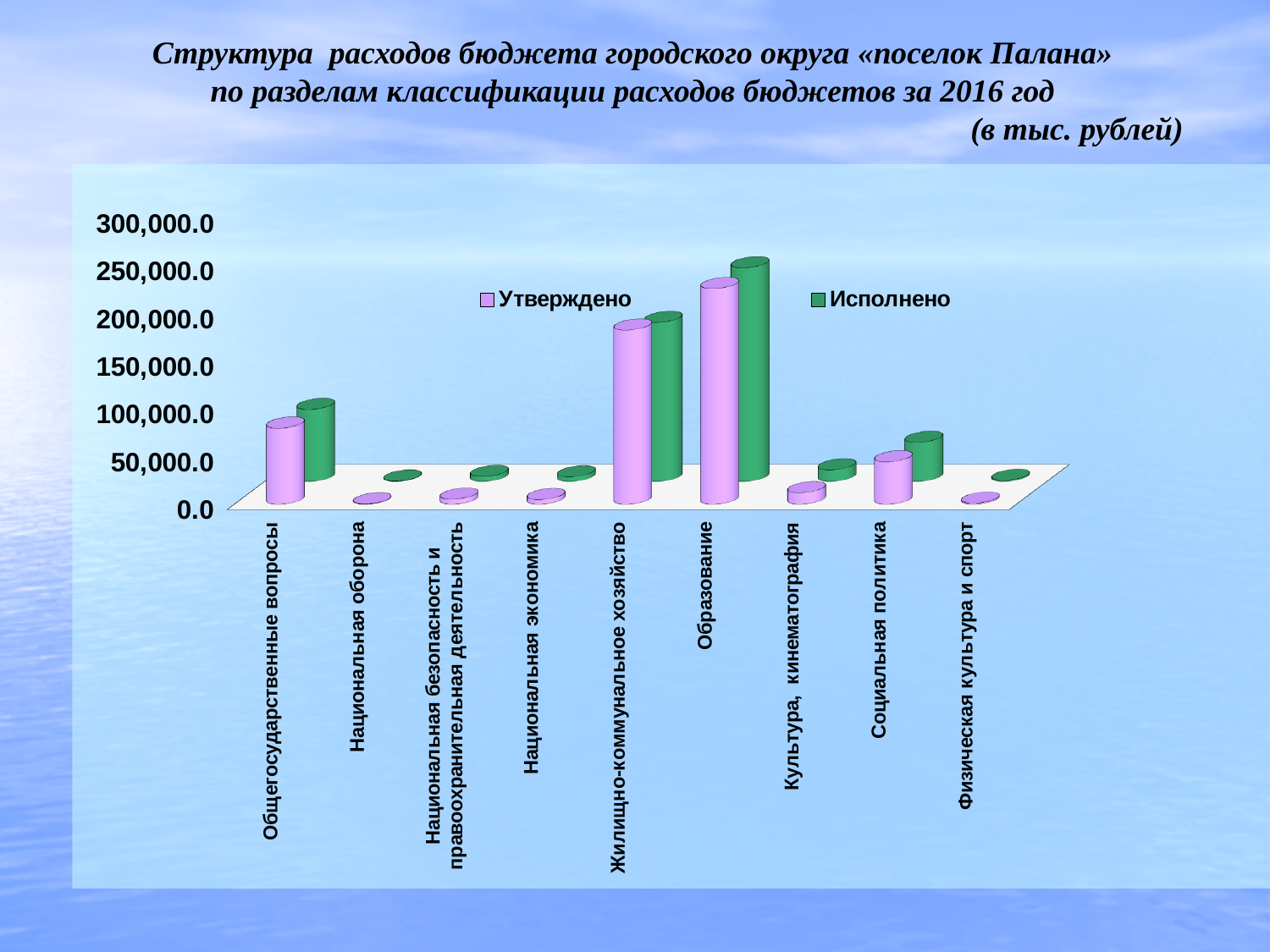
For the Утверждено series, which is larger: Образование or Жилищно-коммунальное хозяйство? Образование Is the Исполнено value for Жилищно-коммунальное хозяйство greater or less than 150,000.0? greater Is the Утверждено value for Общегосударственные вопросы greater or less than 100,000.0? less How many categories are shown on the x axis? 9 How many series does the legend list? 2 What are the two series named in the legend? Утверждено and Исполнено Is the Утверждено value for Образование greater or less than 200,000.0? greater Which category has the highest value for the Утверждено series? Образование What kind of chart is shown on the slide? bar chart Which category has the highest value for the Исполнено series? Образование For the Исполнено series, which is larger: Общегосударственные вопросы or Социальная политика? Общегосударственные вопросы